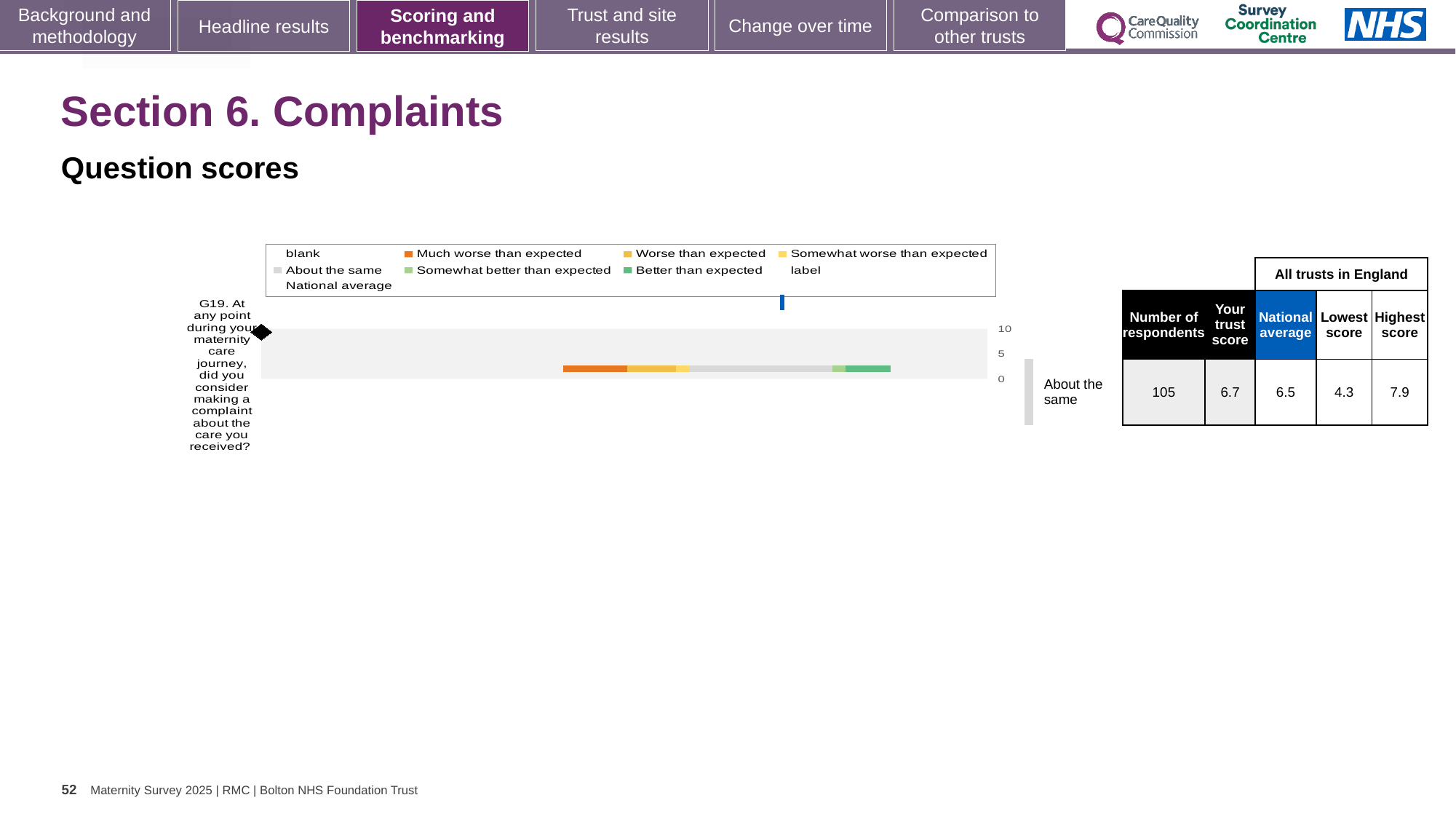
What is the difference between the highest and lowest scores for question G19? 3.6 What is the highest score among all trusts in England for question G19? 7.9 How many respondents answered question G19? 105 What is the lowest score among all trusts in England for question G19? 4.3 What kind of chart is shown on the slide? bar chart What benchmark category is the trust's score for question G19 placed in? About the same Which is larger for question G19, the trust score or the national average? the trust score What is the trust score for question G19? 6.7 Which question is plotted in the chart? G19. At any point during your maternity care journey, did you consider making a complaint about the care you received? What is the national average score for question G19? 6.5 How many survey questions are plotted in the chart? 1 What is the difference between the trust score and the national average for question G19? 0.2